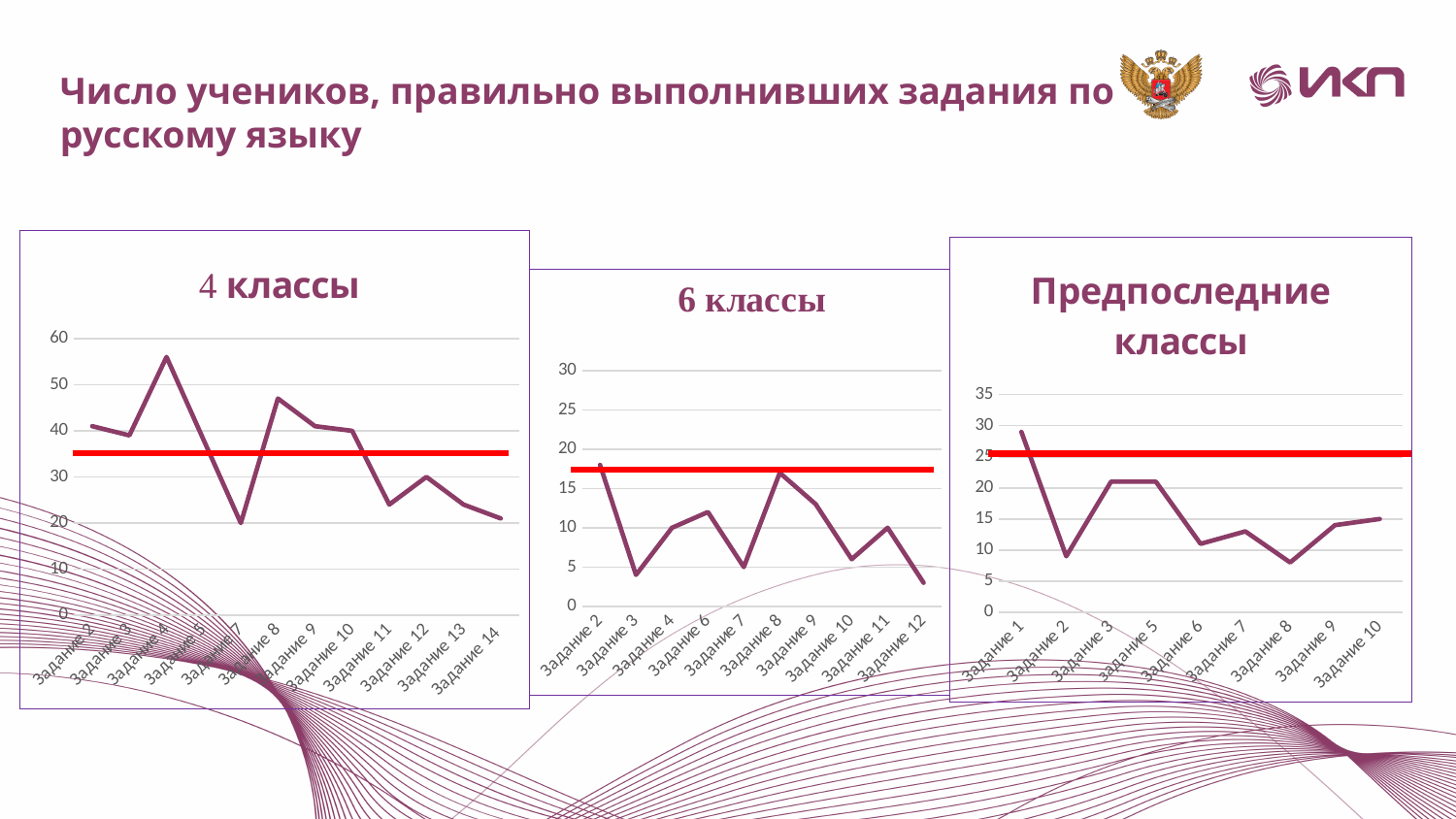
How many data points are plotted in the "6 классы" chart? 10 In the "Предпоследние классы" chart, which task has the highest value? Задание 1 What kind of chart is the "4 классы" chart? line chart In the "6 классы" chart, is the value for Задание 8 greater or less than 15? greater In the "Предпоследние классы" chart, is the value for Задание 1 greater or less than 25? greater How many data points are plotted in the "Предпоследние классы" chart? 9 In the "4 классы" chart, which is larger, the value for Задание 8 or the value for Задание 11? Задание 8 In the "4 классы" chart, is the value for Задание 7 greater or less than 30? less In the "4 классы" chart, which task has the highest value? Задание 4 How many charts are shown on the slide? 3 In the "6 классы" chart, which is larger, the value for Задание 8 or the value for Задание 10? Задание 8